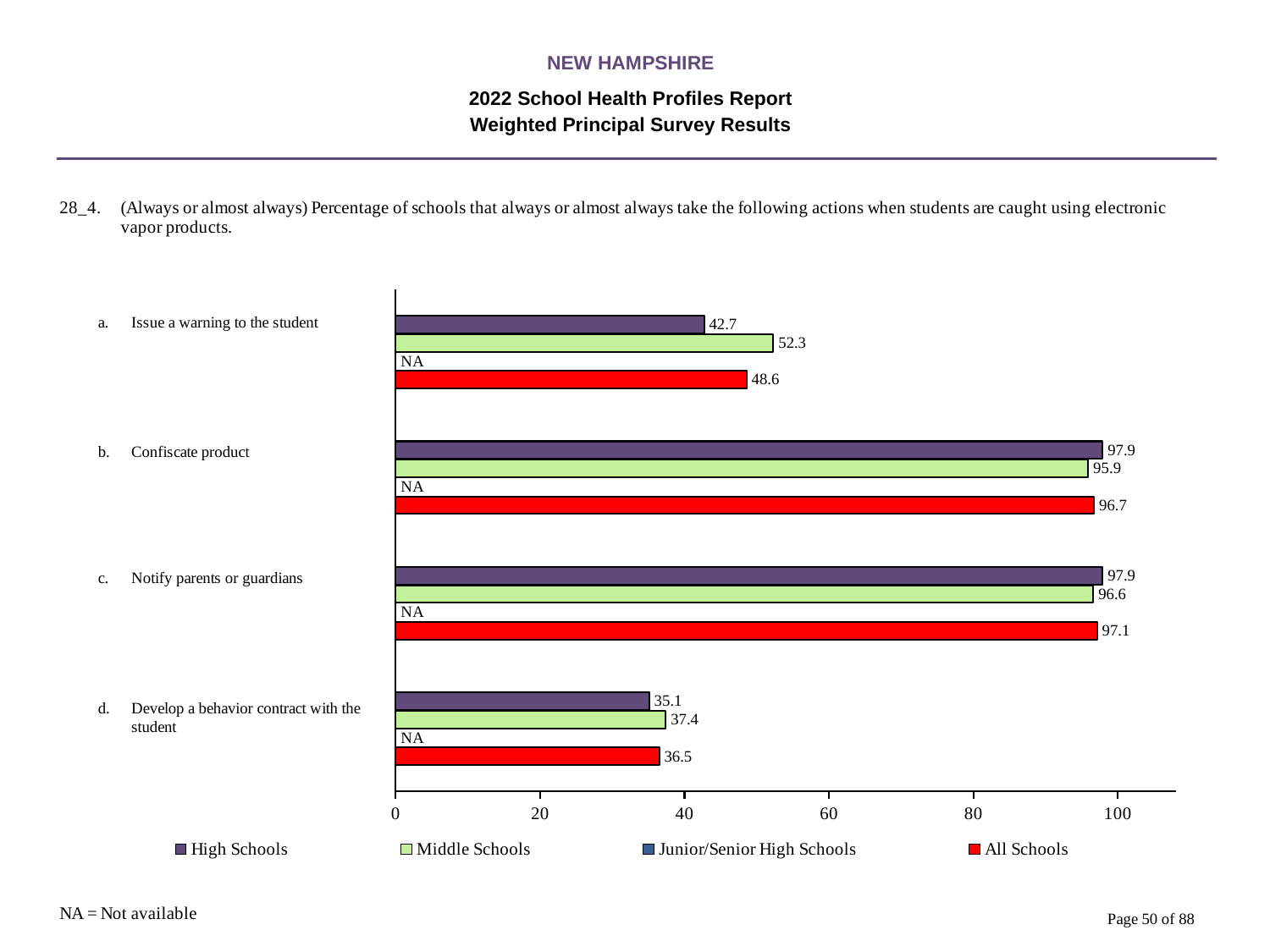
Which action has the highest value for Middle Schools? Notify parents or guardians What is the value for All Schools for "Notify parents or guardians"? 97.1 How many actions (categories) are shown on the chart? 4 What is the value for High Schools for "Issue a warning to the student"? 42.7 What is the value for Middle Schools for "Develop a behavior contract with the student"? 37.4 How many series does the legend list? 4 What is the value for Middle Schools for "Confiscate product"? 95.9 For "Confiscate product", which is larger: the High Schools value or the Middle Schools value? High Schools What value is shown for Junior/Senior High Schools for "Notify parents or guardians"? NA Which action has the lowest value for All Schools? Develop a behavior contract with the student What kind of chart is shown on the slide? Bar chart What is the difference between the Middle Schools and High Schools values for "Issue a warning to the student"? 9.6